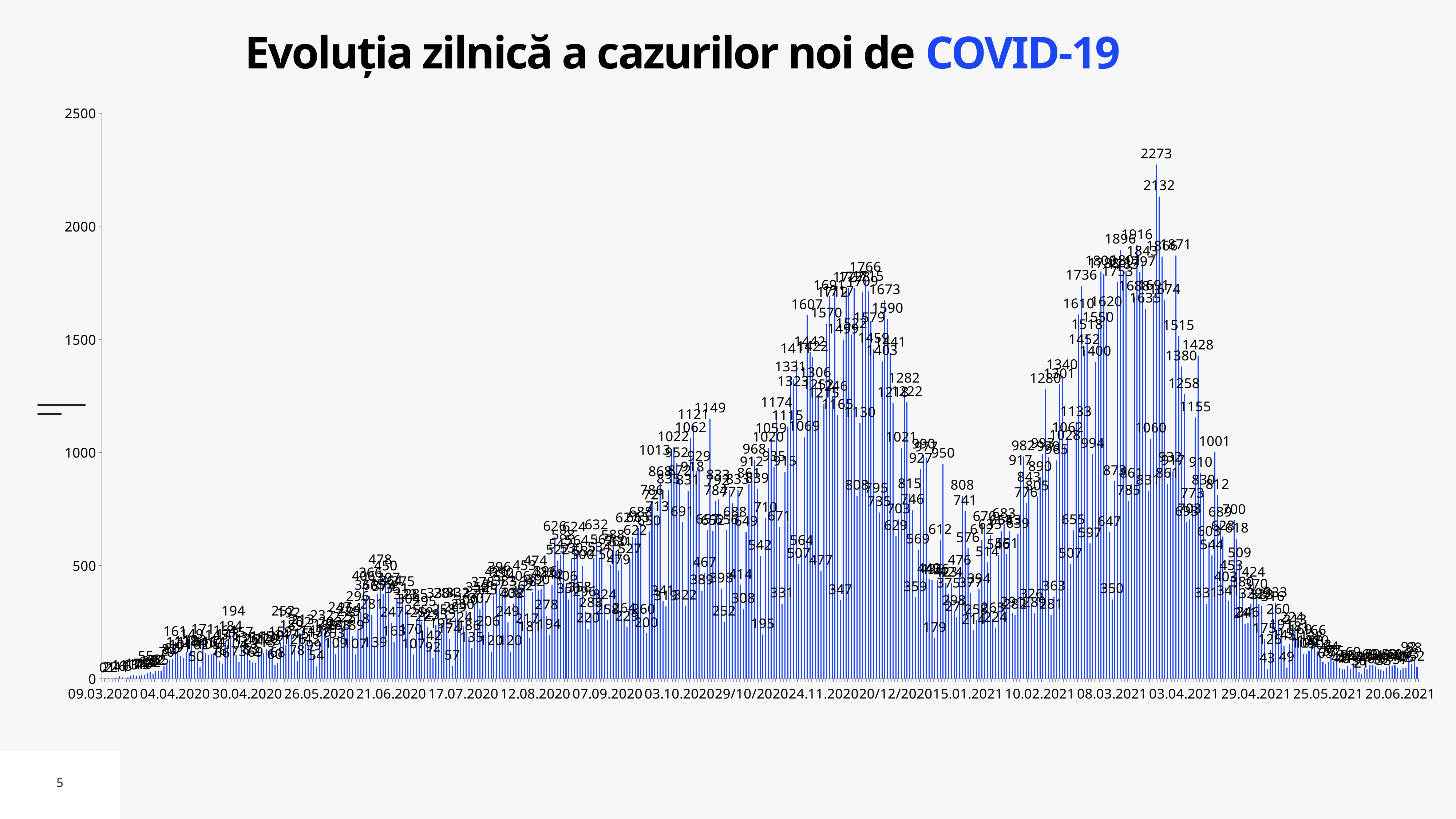
What is the title of the chart? Evoluția zilnică a cazurilor noi de COVID-19 Which is larger: the peak value 1766 labeled near 24.11.2020 or the peak value 2273 labeled near 03.04.2021? 2273 Is the value for the last date, 20.06.2021, greater or less than 500? less How many bars on the chart exceed 2000? 2 What is the second-highest value labeled on the chart? 2132 What is the highest value labeled on the chart? 2273 Do the values rise or fall along the x axis from the peak near 03.04.2021 to 20.06.2021? fall What kind of chart is shown on the slide? bar chart What is the difference between the two highest labeled values, 2273 and 2132? 141 What is the highest tick value shown on the y axis? 2500 Is the highest value on the chart greater or less than 2000? greater What is the first date shown on the x axis? 09.03.2020